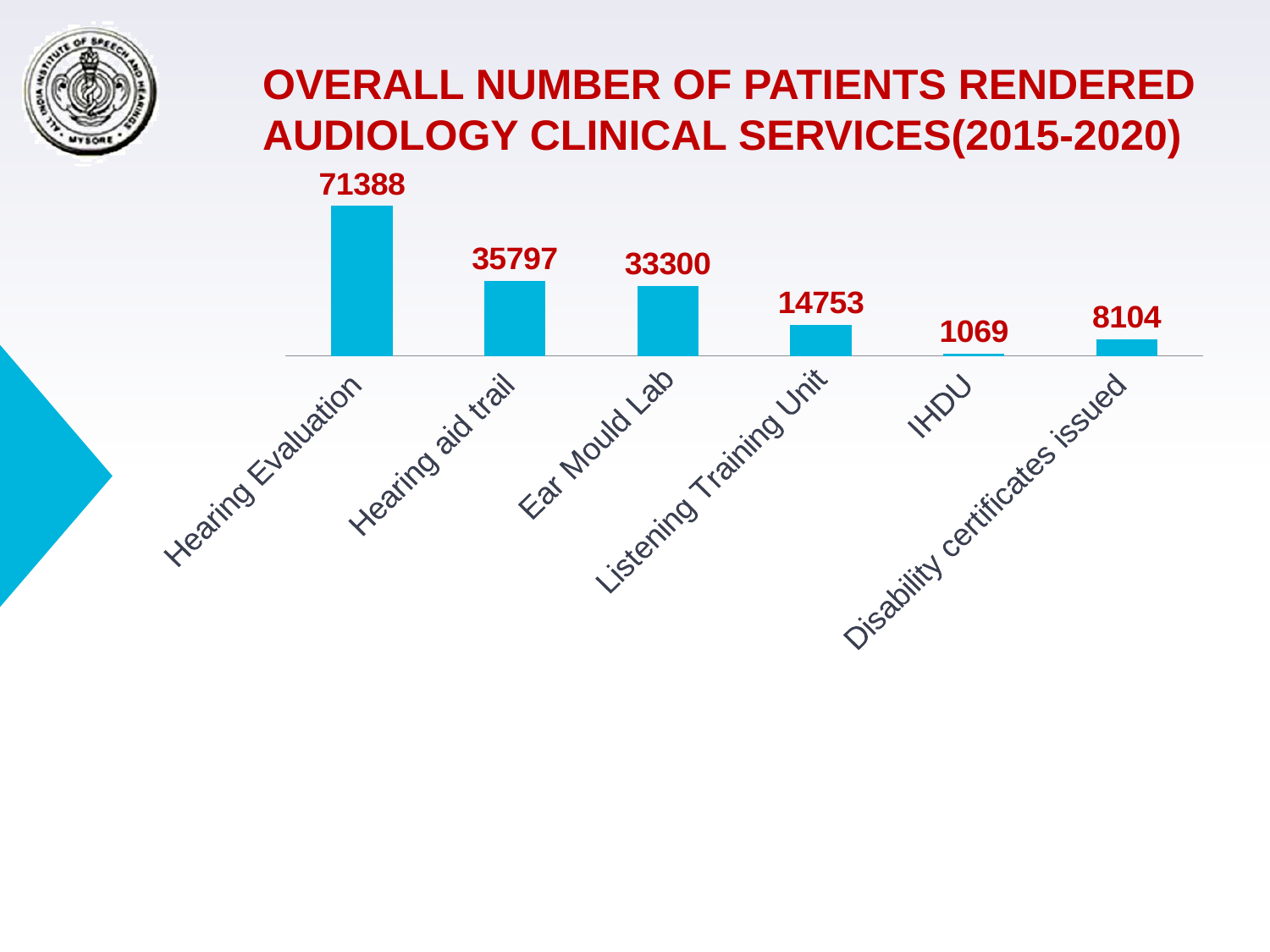
What is the value for Ear Mould Lab? 33300 What kind of chart is shown on the slide? Bar chart Which is larger, the value for Disability certificates issued or the value for IHDU? Disability certificates issued How many categories are shown in the chart? 6 What is the value for Listening Training Unit? 14753 Which category has the lowest value? IHDU What is the value for Disability certificates issued? 8104 What is the value for Hearing aid trail? 35797 What is the value for IHDU? 1069 What is the difference between the values for Hearing Evaluation and Hearing aid trail? 35591 Which category has the highest value? Hearing Evaluation What is the value for Hearing Evaluation? 71388